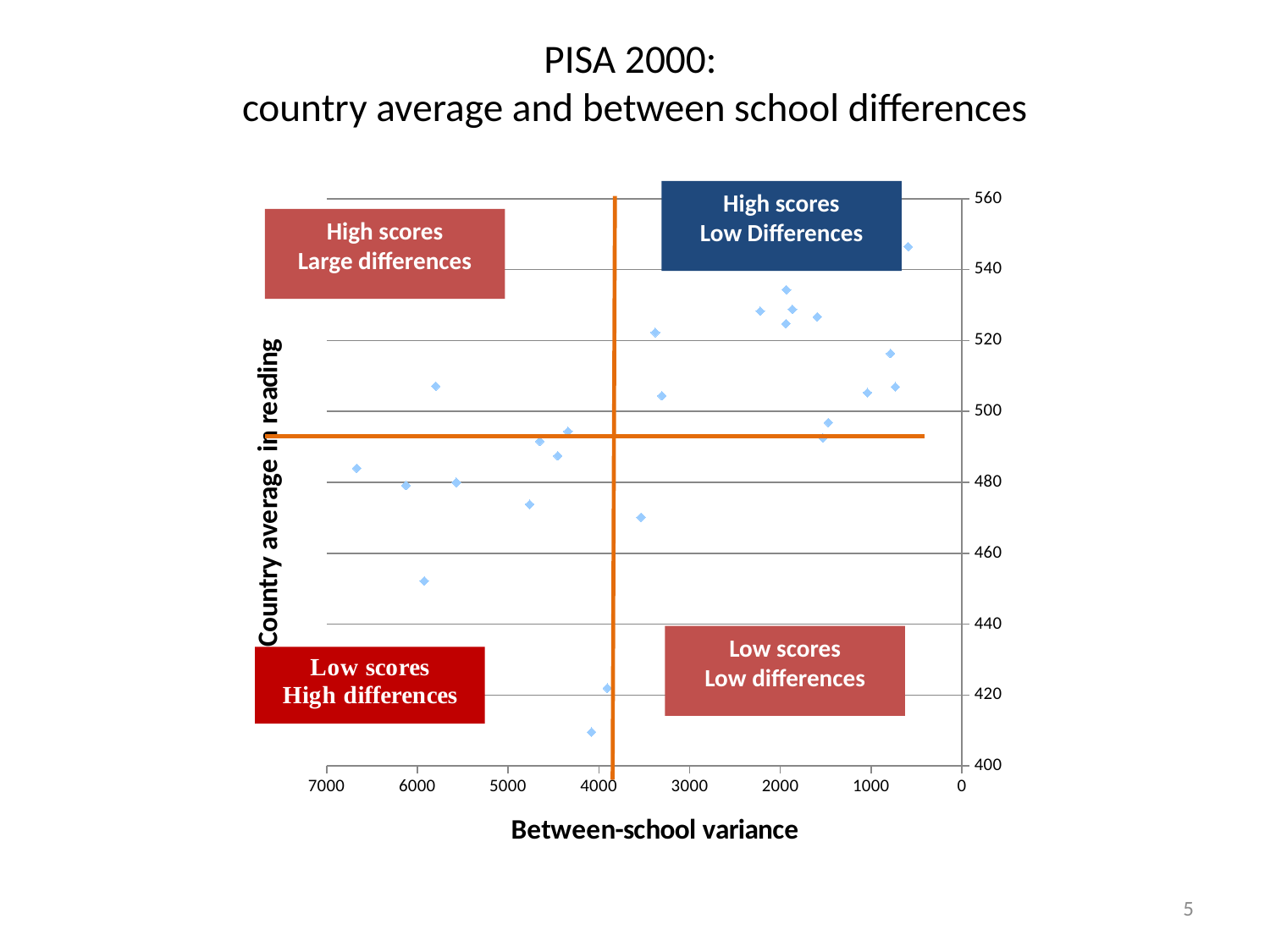
What is the title of the chart's vertical axis? Country average in reading What is the title of the chart's horizontal axis? Between-school variance What kind of chart is shown on the slide? scatter chart Is the between-school variance of the point with the highest reading average greater or less than 1000? less Is the between-school variance of the leftmost plotted point greater or less than 6000? greater What is the largest value shown on the horizontal axis? 7000 What is the highest value shown on the vertical axis? 560 Is the reading average of the highest plotted point greater or less than 540? greater What is the lowest value shown on the vertical axis? 400